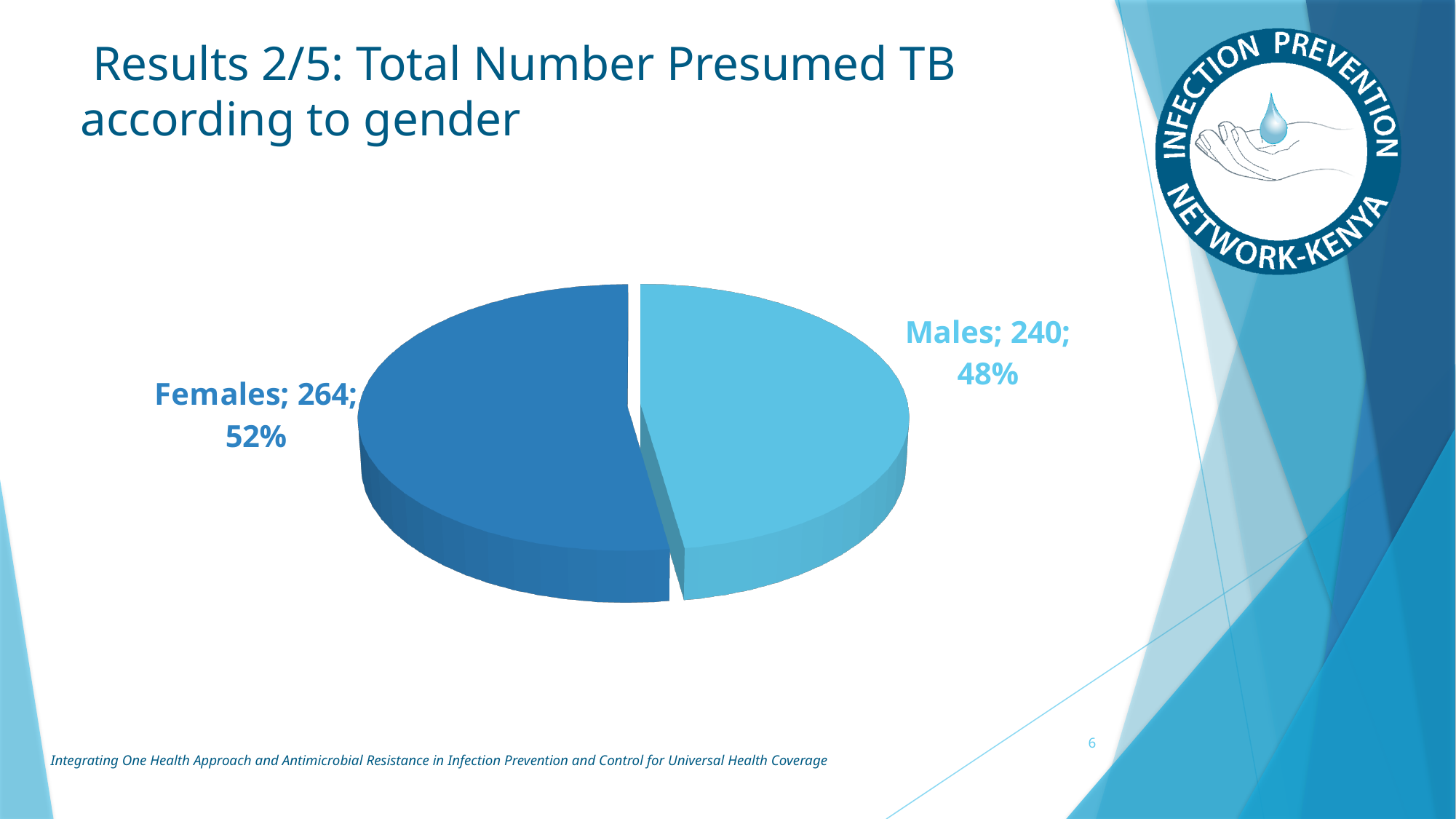
How many presumed TB cases are females? 264 What percentage of presumed TB cases are females? 52% Which slice of the pie chart is shown in the lighter blue colour? Males How many slices does the pie chart have? 2 What is the difference between the number of female and male presumed TB cases? 24 What is the total number of presumed TB cases shown in the pie chart? 504 Which gender has the larger number of presumed TB cases? Females How many presumed TB cases are males? 240 What kind of chart is shown on the slide? Pie chart What percentage of presumed TB cases are males? 48% Which gender has the smaller number of presumed TB cases? Males Is the number of male presumed TB cases greater or less than the number of female cases? less